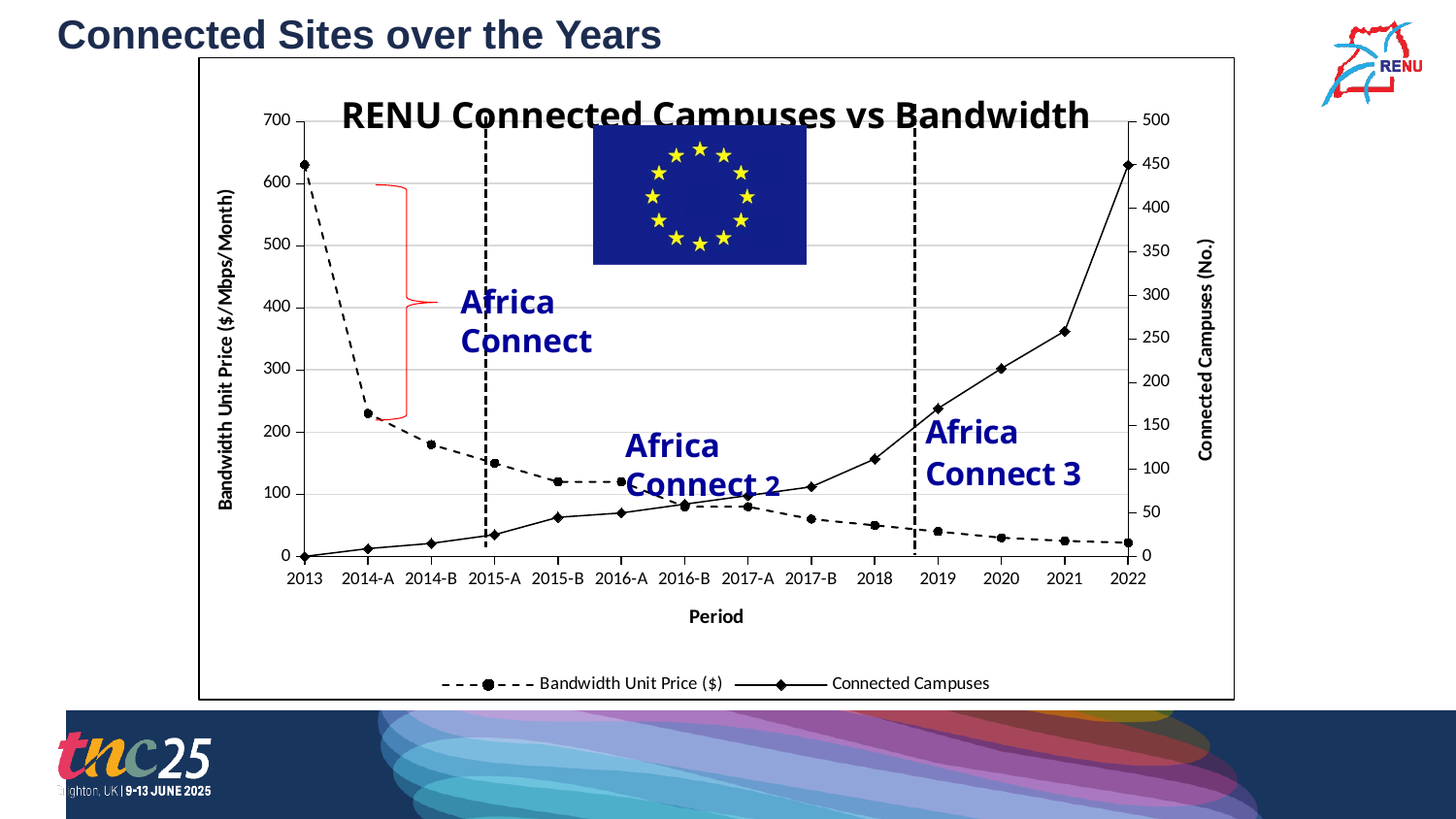
What kind of chart is shown on the slide? Line chart In which period is the number of Connected Campuses lowest? 2013 How many series does the legend list? 2 What is the title of the chart? RENU Connected Campuses vs Bandwidth How many periods are shown along the x axis? 14 In which period is the Bandwidth Unit Price ($) highest? 2013 Is the Bandwidth Unit Price ($) for 2013 greater or less than 600? greater Does the Bandwidth Unit Price ($) rise or fall from 2013 to 2022? Fall In which period is the number of Connected Campuses highest? 2022 What is the label of the left vertical axis? Bandwidth Unit Price ($/Mbps/Month) Is the number of Connected Campuses for 2022 greater or less than 400? greater Do the Connected Campuses rise or fall from 2013 to 2022? Rise